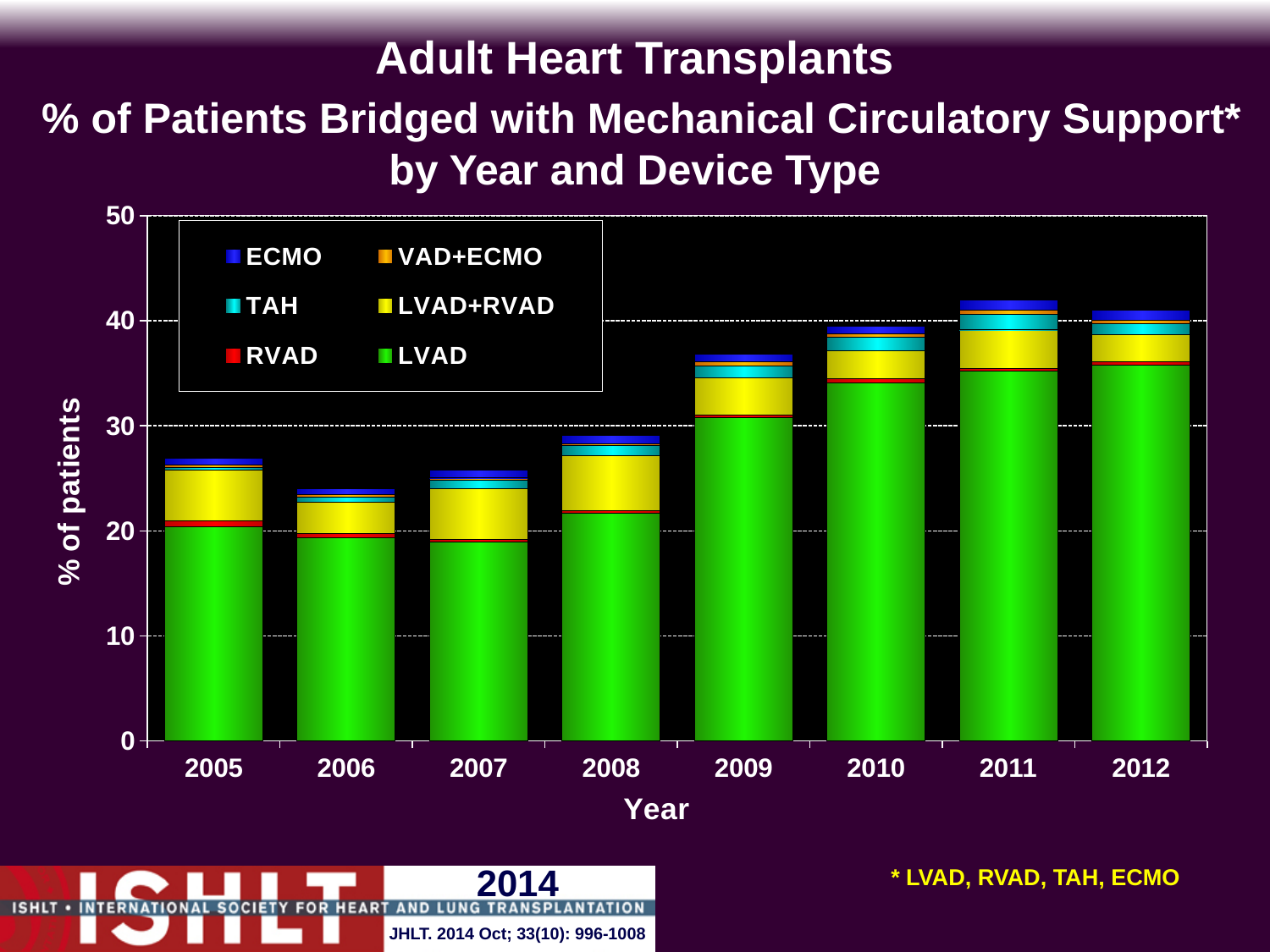
Which device type is shown in green in the chart? LVAD Is the total value for 2011 greater or less than 40? greater Is the total value for 2005 greater or less than 30? less Do the total bar heights generally rise or fall from 2007 to 2011? rise How many device types does the legend list? 6 Which year has a larger total bar, 2005 or 2009? 2009 How many years are shown on the x axis of the chart? 8 Which year has the lowest total percentage of patients bridged with mechanical circulatory support? 2006 Is the total value for 2006 greater or less than 20? greater What is the label on the y axis of the chart? % of patients What kind of chart is shown on the slide? stacked bar chart